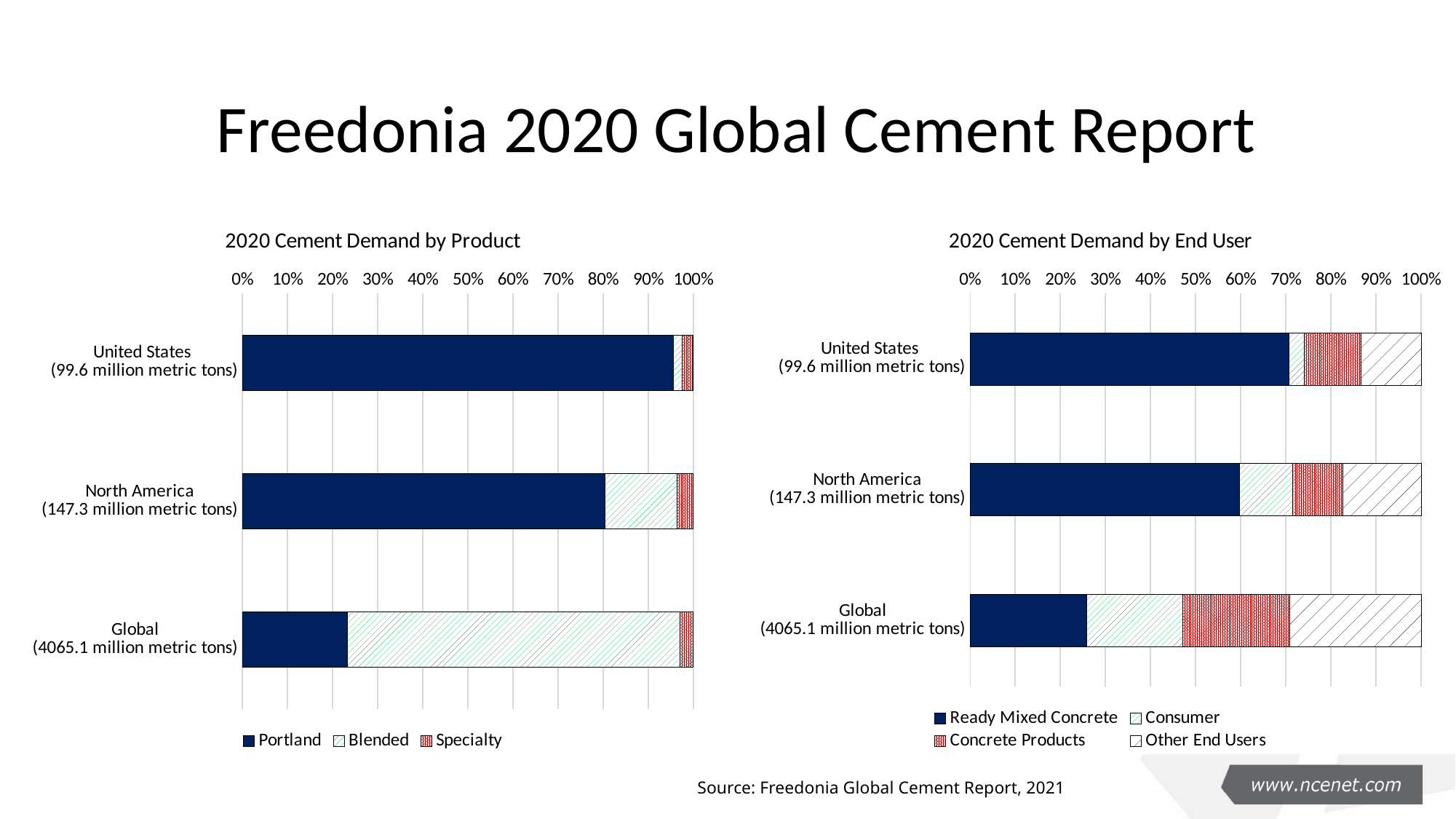
In the '2020 Cement Demand by Product' chart, is the Portland share for United States greater or less than 90%? greater In the '2020 Cement Demand by Product' chart, is the Portland share for Global greater or less than 30%? less What kind of chart is the '2020 Cement Demand by Product' chart? Stacked bar chart How many categories (regions) are shown in the '2020 Cement Demand by Product' chart? 3 In the '2020 Cement Demand by Product' chart, which has the larger Blended share, Global or North America? Global How many series does the legend of the '2020 Cement Demand by Product' chart list? 3 In the '2020 Cement Demand by Product' chart, which region has the lowest Portland share? Global In the '2020 Cement Demand by Product' chart, which region has the highest Portland share? United States How many series does the legend of the '2020 Cement Demand by End User' chart list? 4 In the '2020 Cement Demand by End User' chart, is the Ready Mixed Concrete share for United States greater or less than 60%? greater What is the title of the chart on the right side of the slide? 2020 Cement Demand by End User